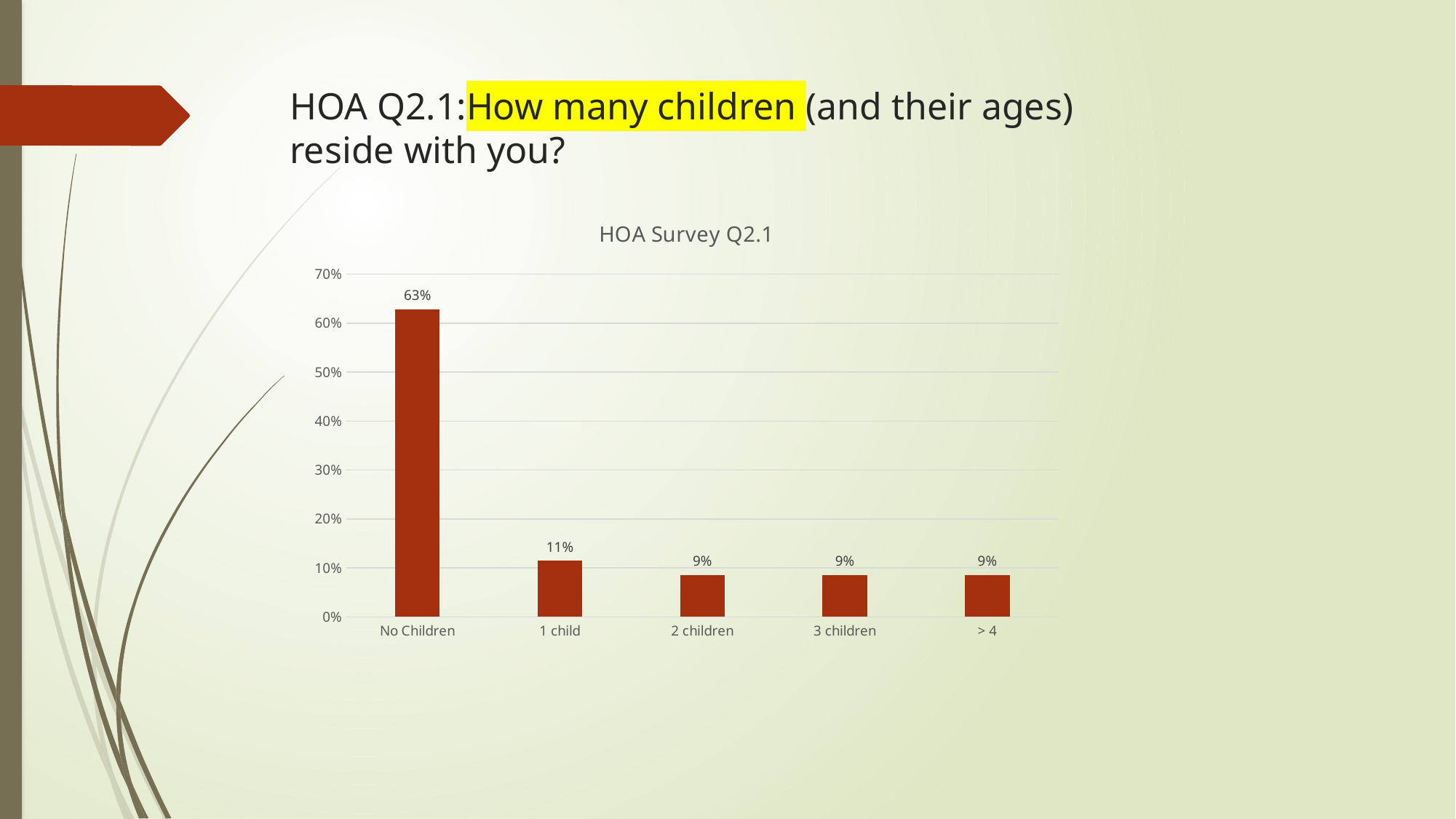
What kind of chart is shown? bar chart How many categories are shown on the x axis? 5 What is the value for No Children? 63% What is the difference between the values for No Children and 1 child? 52% Which is larger, the value for No Children or the value for 1 child? No Children What is the value for 1 child? 11% Is the value for No Children greater or less than 60%? greater What is the value for > 4? 9% What is the value for 2 children? 9% What is the title of the chart? HOA Survey Q2.1 Which category has the highest value? No Children What is the difference between the values for 1 child and 3 children? 2%